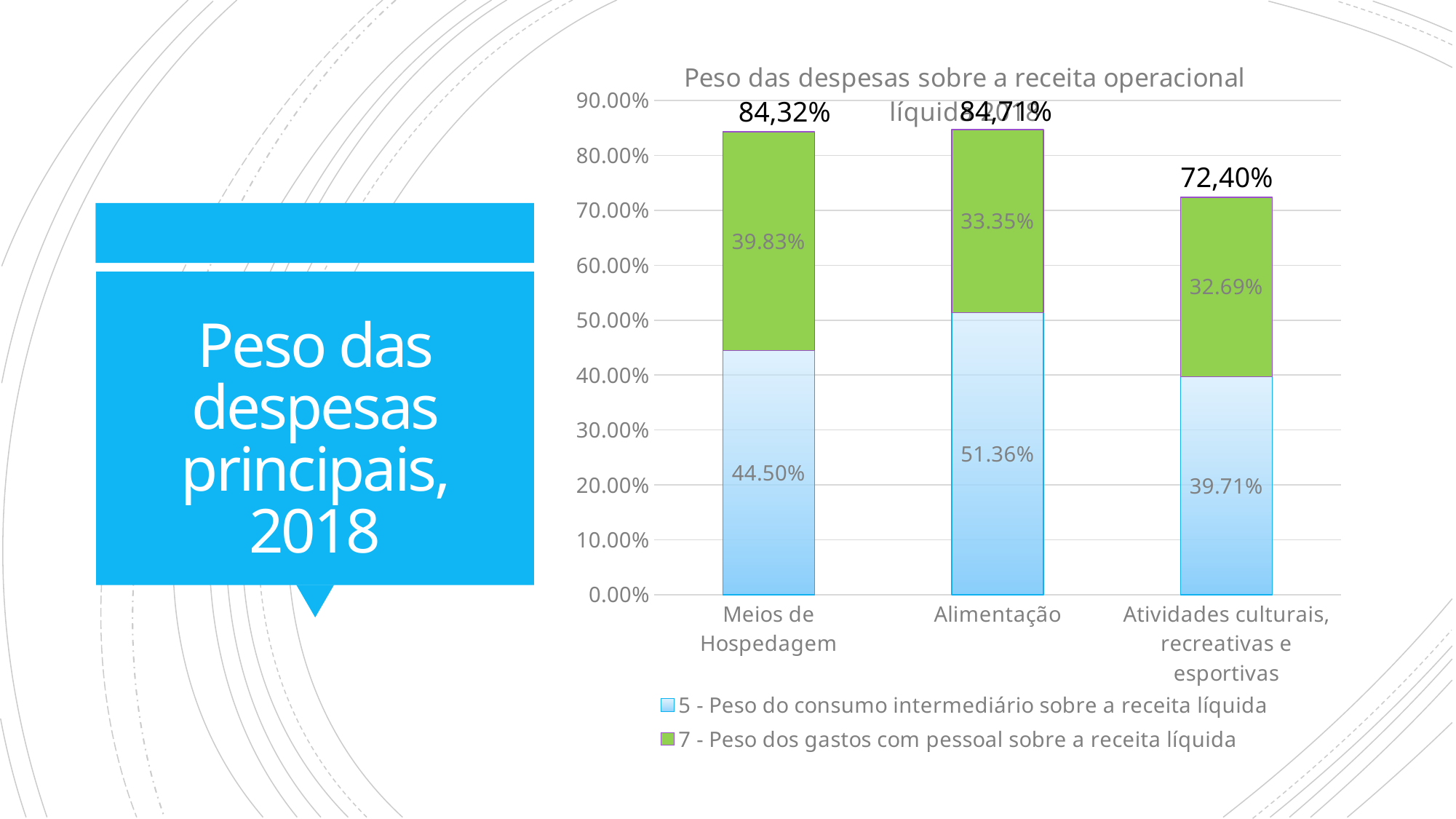
Which category has the highest value for '5 - Peso do consumo intermediário sobre a receita líquida'? Alimentação What is the value of '5 - Peso do consumo intermediário sobre a receita líquida' for Atividades culturais, recreativas e esportivas? 39.71% What kind of chart is shown on the slide? Stacked bar chart For Meios de Hospedagem, which is larger: the consumo intermediário segment or the gastos com pessoal segment? Consumo intermediário (44.50%) How many series does the legend list? 2 What is the value of '7 - Peso dos gastos com pessoal sobre a receita líquida' for Meios de Hospedagem? 39.83% How many categories are shown on the x axis of the chart? 3 What is the difference between the '5 - Peso do consumo intermediário' values for Alimentação and Meios de Hospedagem? 6.86% What is the value of '7 - Peso dos gastos com pessoal sobre a receita líquida' for Atividades culturais, recreativas e esportivas? 32.69% What is the value of '5 - Peso do consumo intermediário sobre a receita líquida' for Alimentação? 51.36% What total is shown above the stacked bar for Meios de Hospedagem? 84,32% Which category has the lowest total shown above its stacked bar? Atividades culturais, recreativas e esportivas